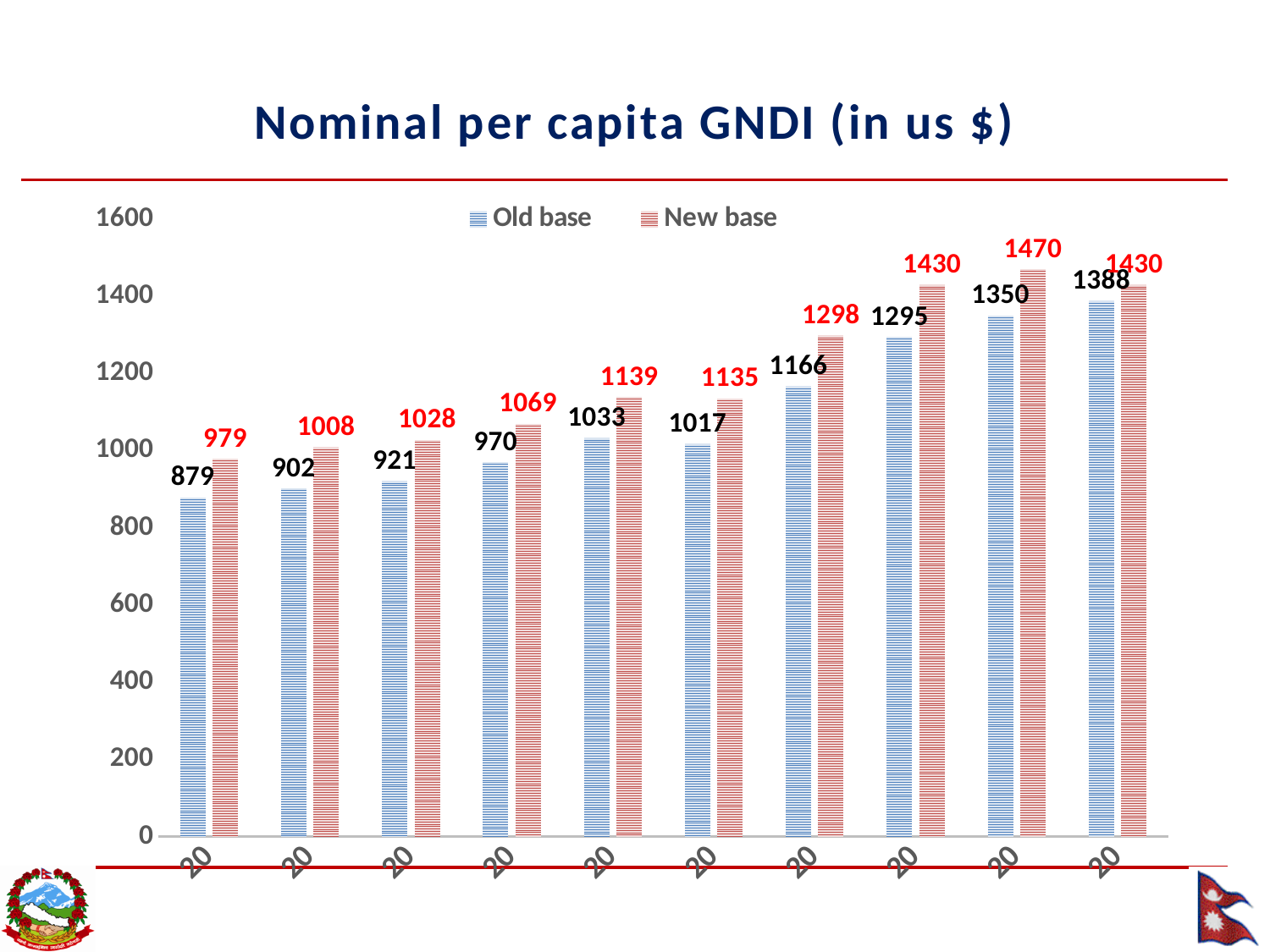
What is the lowest Old base value shown on the chart? 879 In the first (leftmost) group, what is the difference between the New base and Old base values? 100 How many groups of bars are plotted along the x axis? 10 What is the Old base value for the first (leftmost) group of bars? 879 What is the highest New base value shown on the chart? 1470 What kind of chart is shown on the slide? Bar chart What are the two entries listed in the chart legend? Old base and New base In the sixth group from the left, which is larger, the Old base value or the New base value? New base What is the New base value for the last (rightmost) group of bars? 1430 In the last (rightmost) group, what is the difference between the New base and Old base values? 42 How many series does the legend list? 2 Do the Old base values generally rise or fall from left to right along the x axis? Rise